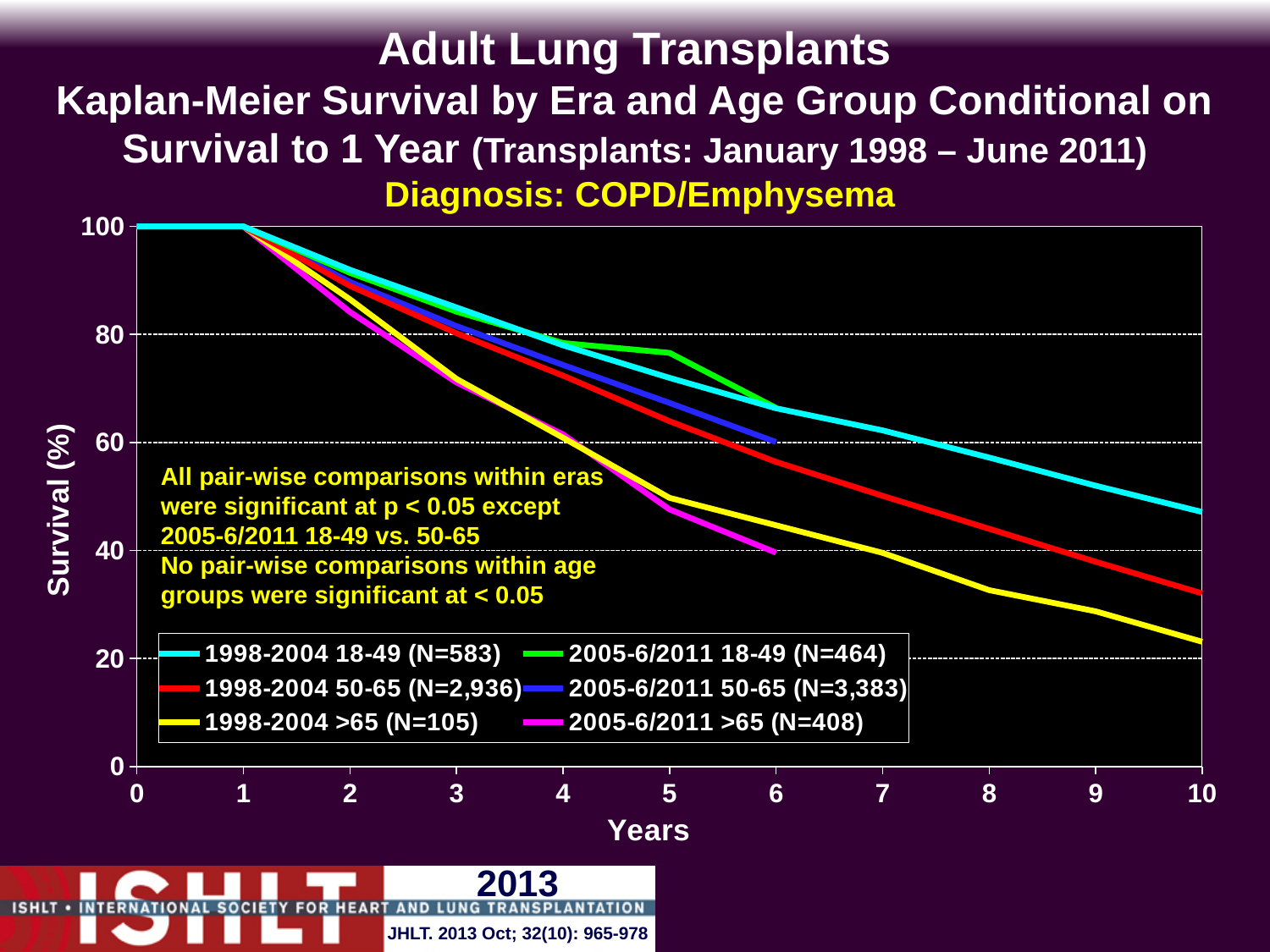
How many series does the legend list? 6 Do the survival curves rise or fall as years increase? fall What is the N for the 1998-2004 50-65 series in the legend? 2,936 Is the survival for 1998-2004 50-65 at 10 years greater or less than 40? less Is the survival for 1998-2004 18-49 at 10 years greater or less than 60? less Is the survival for 1998-2004 >65 at 10 years greater or less than 20? greater What type of chart is shown on the slide? line chart What is the diagnosis shown in the chart title? COPD/Emphysema At 10 years, which series has higher survival: 1998-2004 18-49 or 1998-2004 50-65? 1998-2004 18-49 Which series has the lowest survival at 10 years? 1998-2004 >65 (N=105) What is the N for the 2005-6/2011 >65 series in the legend? 408